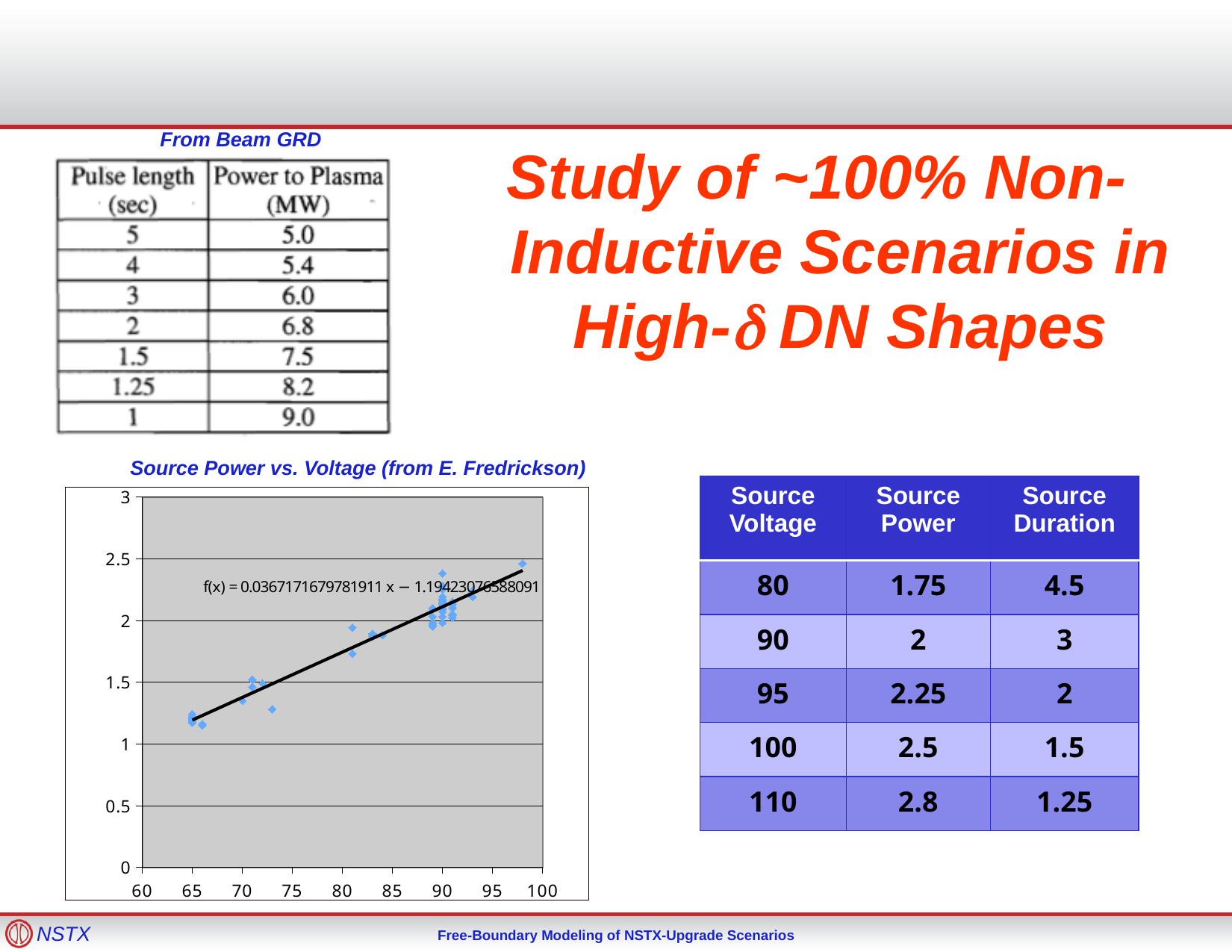
What trendline equation is printed on the Source Power vs. Voltage chart? f(x) = 0.0367171679781911 x − 1.19423076588091 In the Source Power vs. Voltage chart, are the values for the cluster of points at voltage 90 greater or less than 1.5? greater In the Source Power vs. Voltage chart, is the value for the point at voltage 81 greater or less than 2.5? less In the Source Power vs. Voltage chart, is the value for the point at voltage 65 greater or less than 1? greater What is the title printed above the scatter chart on the slide? Source Power vs. Voltage (from E. Fredrickson) What kind of chart is shown under the title 'Source Power vs. Voltage (from E. Fredrickson)'? scatter chart In the Source Power vs. Voltage chart, do the plotted values rise or fall as voltage increases along the x axis? rise